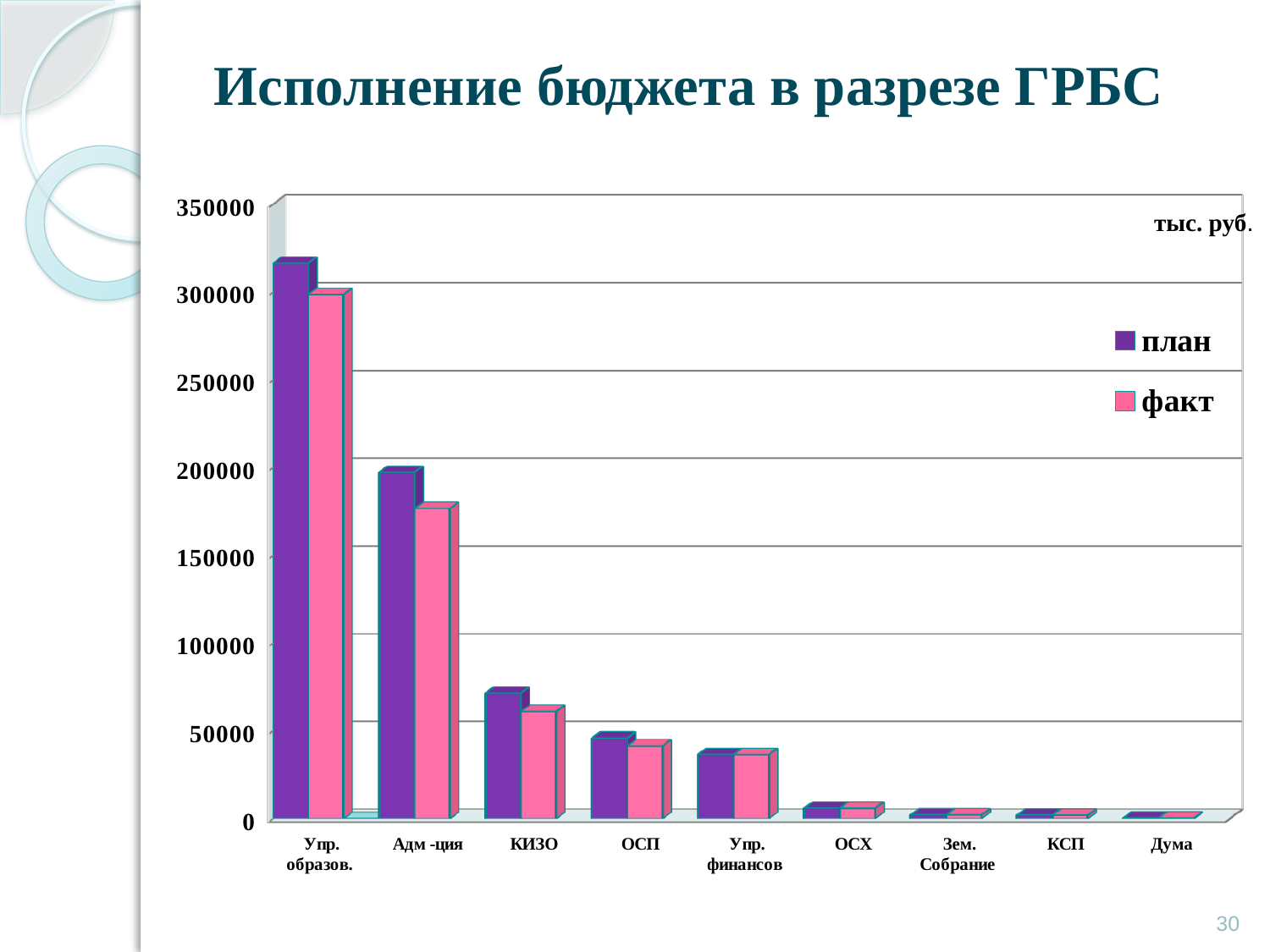
Is the план value for Упр. финансов greater or less than 50000? less How many categories are shown on the x axis? 9 Is the факт value for Адм -ция greater or less than 200000? less Which category has the highest план value? Упр. образов. Do the план values rise or fall moving from left to right along the x axis? fall For Адм -ция, which is larger: план or факт? план How many series does the legend list? 2 What unit is indicated in the top right corner of the chart? тыс. руб. Which category has the highest факт value? Упр. образов. What kind of chart is shown on the slide? bar chart Is the план value for КИЗО greater or less than 50000? greater